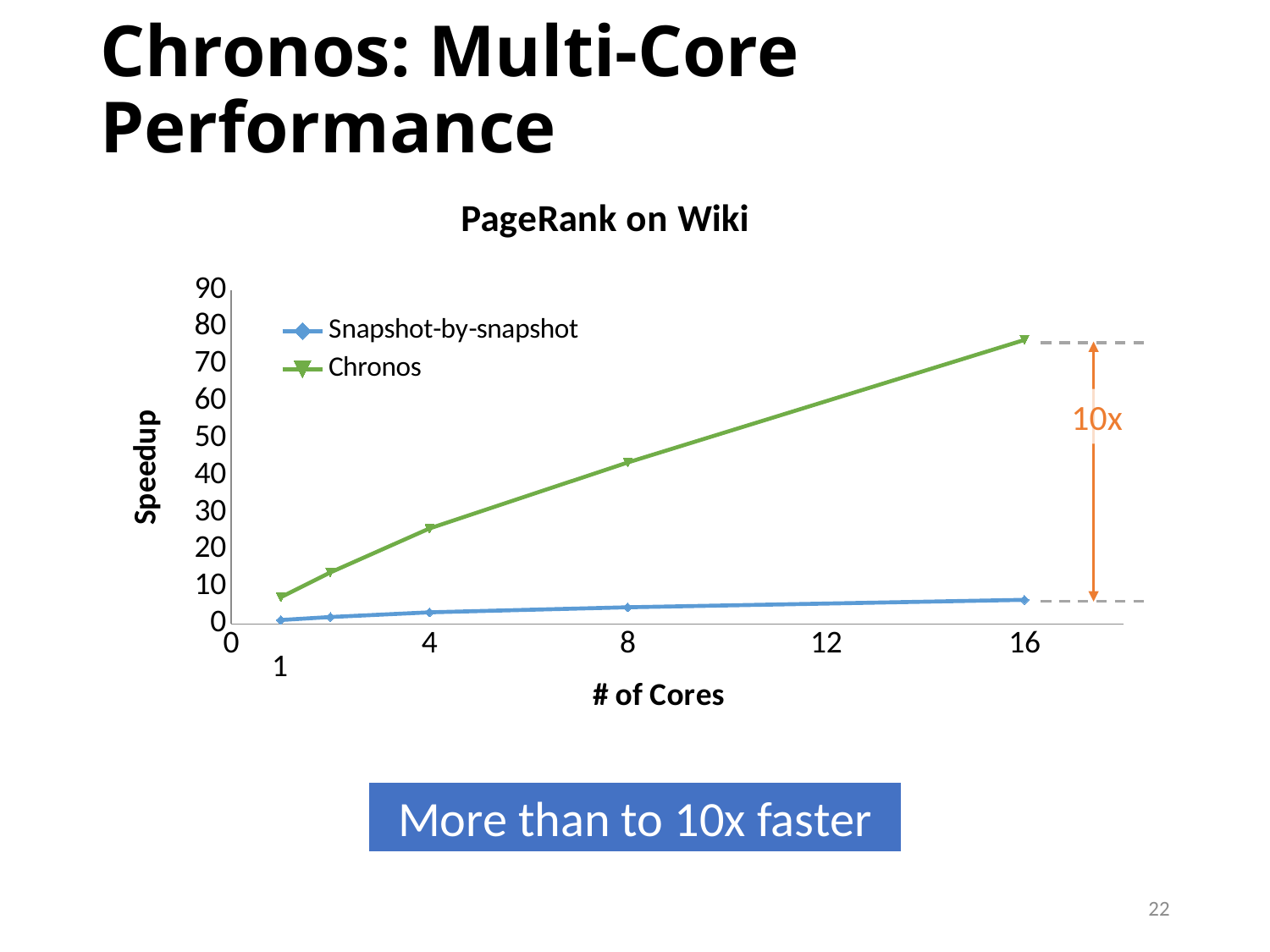
What kind of chart is shown on the slide? line chart Is the speedup for Snapshot-by-snapshot at 16 cores greater or less than 10? less At which number of cores does Chronos reach its highest speedup? 16 What is the label of the y axis? Speedup How many series does the legend list? 2 Which series has the higher speedup at 16 cores, Chronos or Snapshot-by-snapshot? Chronos What is the title of the chart? PageRank on Wiki Is the speedup for Chronos at 8 cores greater or less than 40? greater Is the speedup for Chronos at 16 cores greater or less than 70? greater How many data points are plotted for the Chronos series? 5 Does the Chronos speedup rise or fall as the number of cores increases? rise